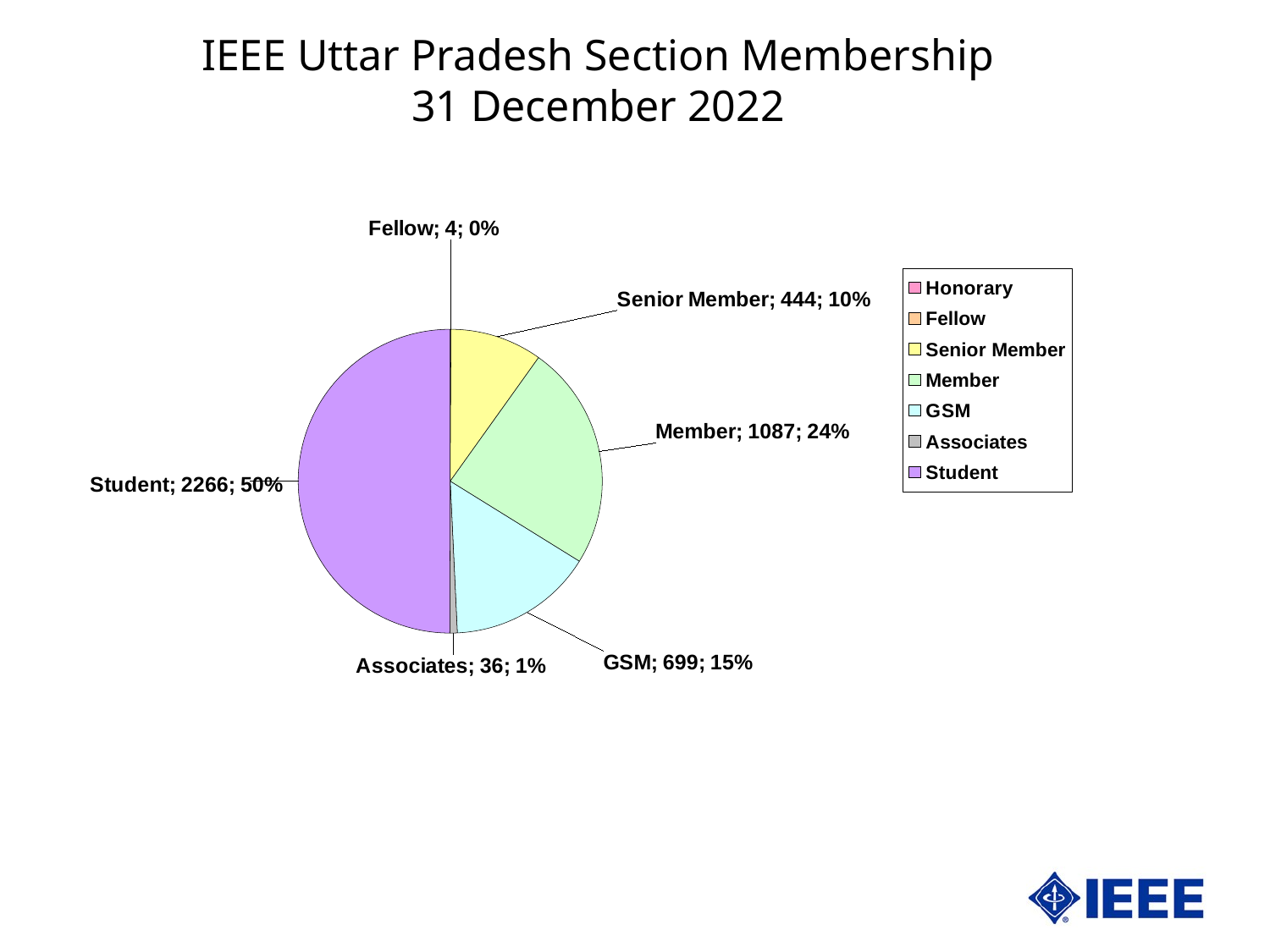
What type of chart is shown on the slide? pie chart Which category has the largest slice of the pie? Student What is the value shown for Associates? 36 What is the title of the chart? IEEE Uttar Pradesh Section Membership 31 December 2022 What is the value shown for Member? 1087 What is the difference between the Member value and the GSM value? 388 Which is larger, the Senior Member value or the GSM value? GSM How many members does the Student slice represent? 2266 How many entries does the legend list? 7 Which labelled category has the smallest value? Fellow What percentage share does Senior Member have in the pie? 10% What percentage share does GSM have in the pie? 15%